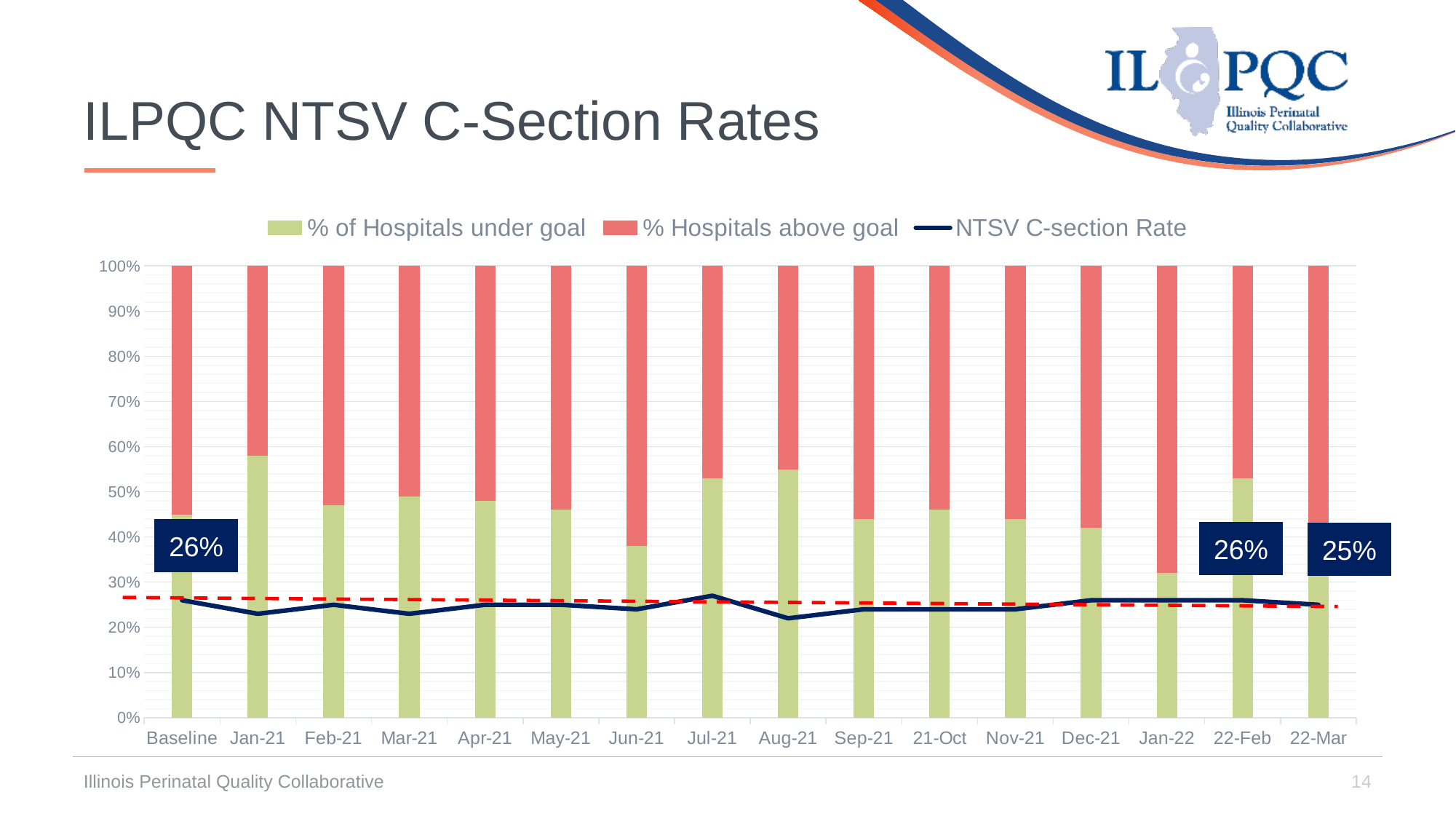
How many categories are shown on the x axis? 16 What is the NTSV C-section Rate at Baseline? 26% Which is larger, the % of Hospitals under goal for Jan-21 or for Jun-21? Jan-21 Which month has the lowest % of Hospitals under goal? Jan-22 Is the % of Hospitals under goal for Jan-22 greater or less than 40%? less What kind of chart is this? Stacked bar chart with a line Is the % of Hospitals under goal for Jan-21 greater or less than 50%? greater How many series does the legend list? 3 What is the difference between the NTSV C-section Rate at Baseline and at 22-Mar? 1% What is the NTSV C-section Rate for 22-Mar? 25% What is the NTSV C-section Rate for 22-Feb? 26% What is the total of the stacked bar for Baseline? 100%